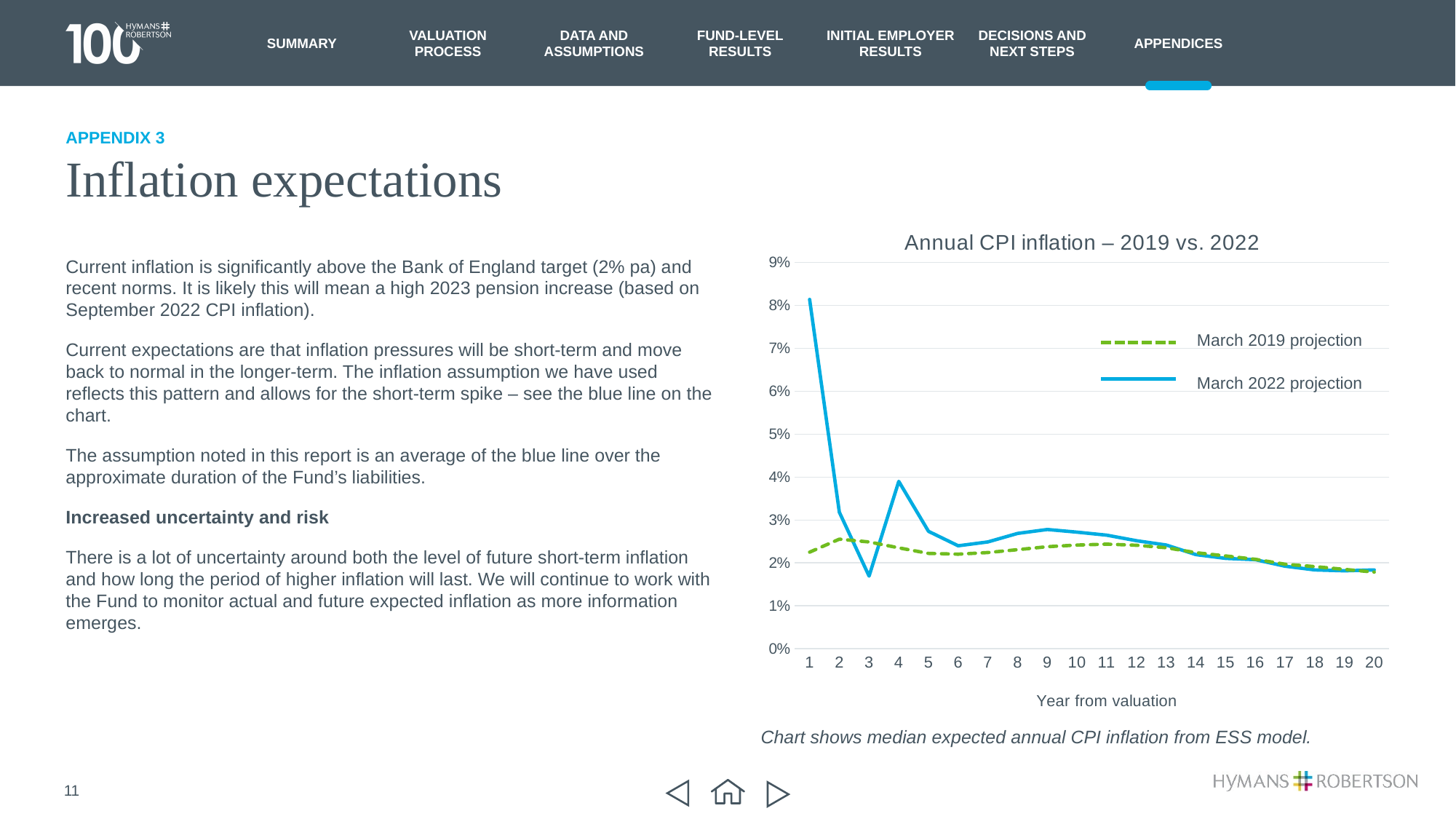
Is the March 2022 projection value in year 1 greater or less than 7%? greater How many years from valuation are plotted along the x axis? 20 What is the title of the chart? Annual CPI inflation – 2019 vs. 2022 In which year from valuation is the March 2022 projection at its highest? 1 What is the label of the x axis? Year from valuation Is the March 2022 projection value in year 3 greater or less than 2%? less In which year from valuation is the March 2022 projection at its lowest? 3 What kind of chart is shown on the slide? Line chart In year 4, which is larger: the March 2019 projection or the March 2022 projection? March 2022 projection Is the March 2019 projection value in year 1 greater or less than 3%? less How many series does the chart legend list? 2 Does the March 2022 projection rise or fall from year 1 to year 3? Fall